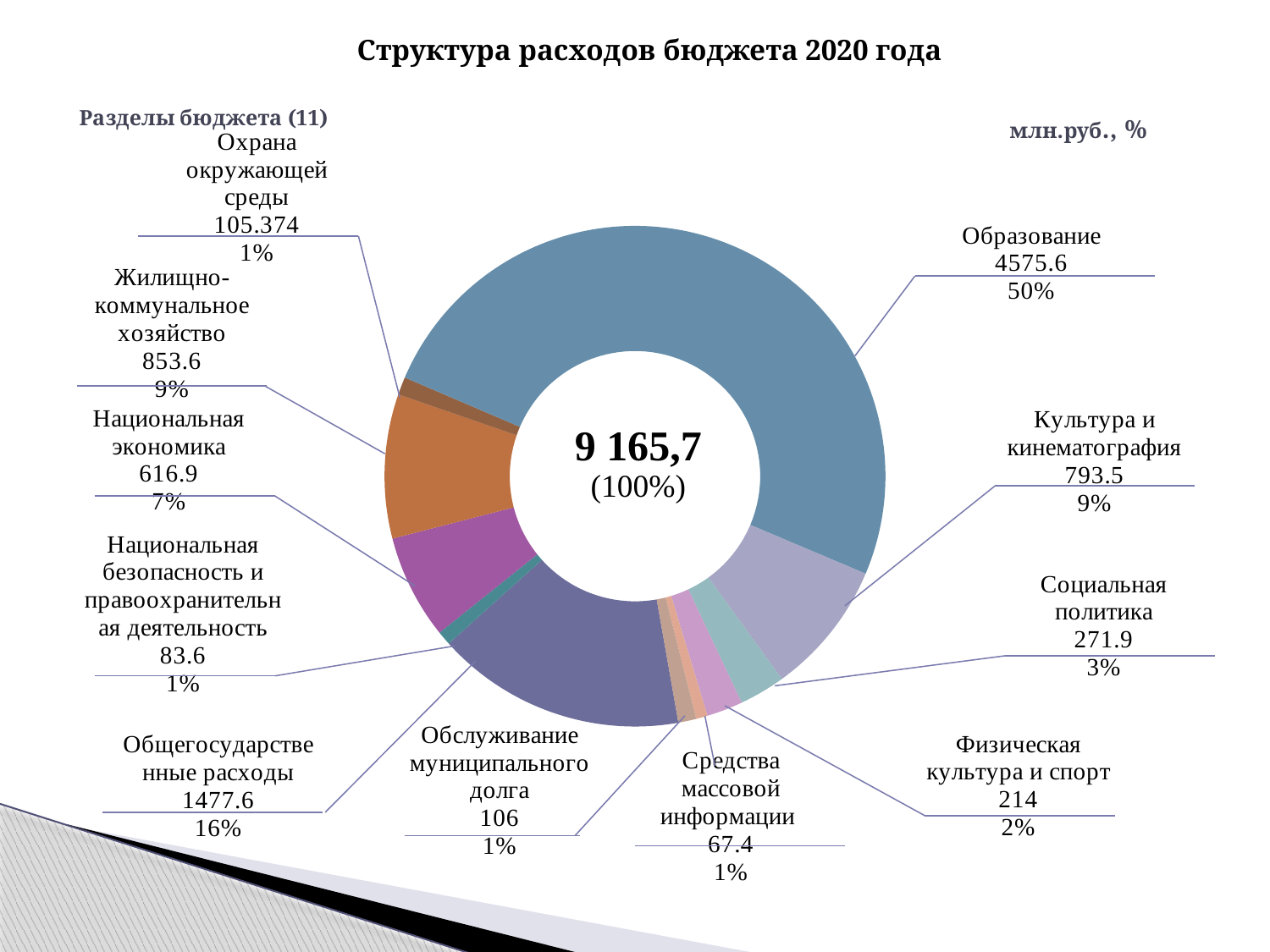
What kind of chart is shown on the slide? doughnut chart What is the difference between the values for Образование and Общегосударственные расходы? 3098 What is the value for Образование? 4575.6 What share of the total does Культура и кинематография account for? 9% What share of the total does Общегосударственные расходы account for? 16% What is the value for Общегосударственные расходы? 1477.6 How many categories are shown in the chart? 11 Which category has the highest value? Образование What total value is shown in the centre of the chart? 9 165,7 Which is larger, Национальная экономика or Социальная политика? Национальная экономика Which category has the lowest value? Средства массовой информации What is the value for Охрана окружающей среды? 105.374